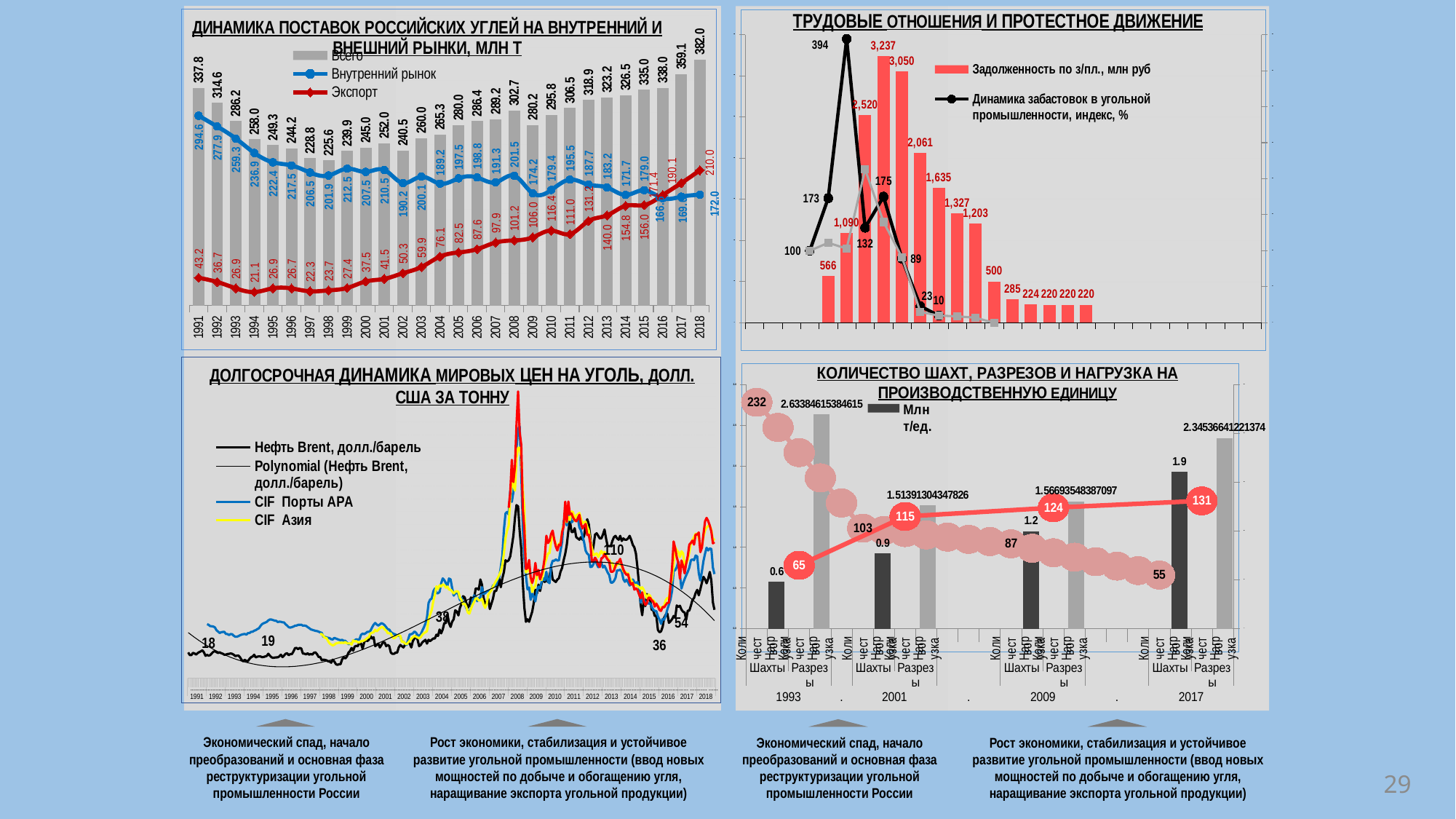
In the chart 'КОЛИЧЕСТВО ШАХТ, РАЗРЕЗОВ И НАГРУЗКА НА ПРОИЗВОДСТВЕННУЮ ЕДИНИЦУ', which is larger: the value 232 labelled for 1993 or the value 55 labelled for 2017? 232 (1993) In the chart 'ТРУДОВЫЕ ОТНОШЕНИЯ И ПРОТЕСТНОЕ ДВИЖЕНИЕ', how many red bars for 'Задолженность по з/пл., млн руб' are plotted? 15 In the chart 'ТРУДОВЫЕ ОТНОШЕНИЯ И ПРОТЕСТНОЕ ДВИЖЕНИЕ', what is the highest value of 'Задолженность по з/пл., млн руб'? 3,237 What kind of chart is 'ДОЛГОСРОЧНАЯ ДИНАМИКА МИРОВЫХ ЦЕН НА УГОЛЬ, ДОЛЛ. США ЗА ТОННУ'? line chart In the chart 'ТРУДОВЫЕ ОТНОШЕНИЯ И ПРОТЕСТНОЕ ДВИЖЕНИЕ', what is the peak value of 'Динамика забастовок в угольной промышленности, индекс, %'? 394 In the chart 'ДОЛГОСРОЧНАЯ ДИНАМИКА МИРОВЫХ ЦЕН НА УГОЛЬ, ДОЛЛ. США ЗА ТОННУ', how many entries does the legend list? 4 In the chart 'ДИНАМИКА ПОСТАВОК РОССИЙСКИХ УГЛЕЙ НА ВНУТРЕННИЙ И ВНЕШНИЙ РЫНКИ, МЛН Т', what is the value of 'Всего' for 2018? 382.0 In the chart 'ДИНАМИКА ПОСТАВОК РОССИЙСКИХ УГЛЕЙ НА ВНУТРЕННИЙ И ВНЕШНИЙ РЫНКИ, МЛН Т', how many series does the legend list? 3 In the chart 'ДИНАМИКА ПОСТАВОК РОССИЙСКИХ УГЛЕЙ НА ВНУТРЕННИЙ И ВНЕШНИЙ РЫНКИ, МЛН Т', what is the value of 'Экспорт' for 1994? 21.1 In the chart 'ДИНАМИКА ПОСТАВОК РОССИЙСКИХ УГЛЕЙ НА ВНУТРЕННИЙ И ВНЕШНИЙ РЫНКИ, МЛН Т', does 'Экспорт' generally rise or fall from 2000 to 2018? rise In the chart 'ДИНАМИКА ПОСТАВОК РОССИЙСКИХ УГЛЕЙ НА ВНУТРЕННИЙ И ВНЕШНИЙ РЫНКИ, МЛН Т', which year has the lowest 'Всего' value? 1998 In the chart 'ДИНАМИКА ПОСТАВОК РОССИЙСКИХ УГЛЕЙ НА ВНУТРЕННИЙ И ВНЕШНИЙ РЫНКИ, МЛН Т', what is the difference between 'Внутренний рынок' in 1991 and in 2018? 122.6